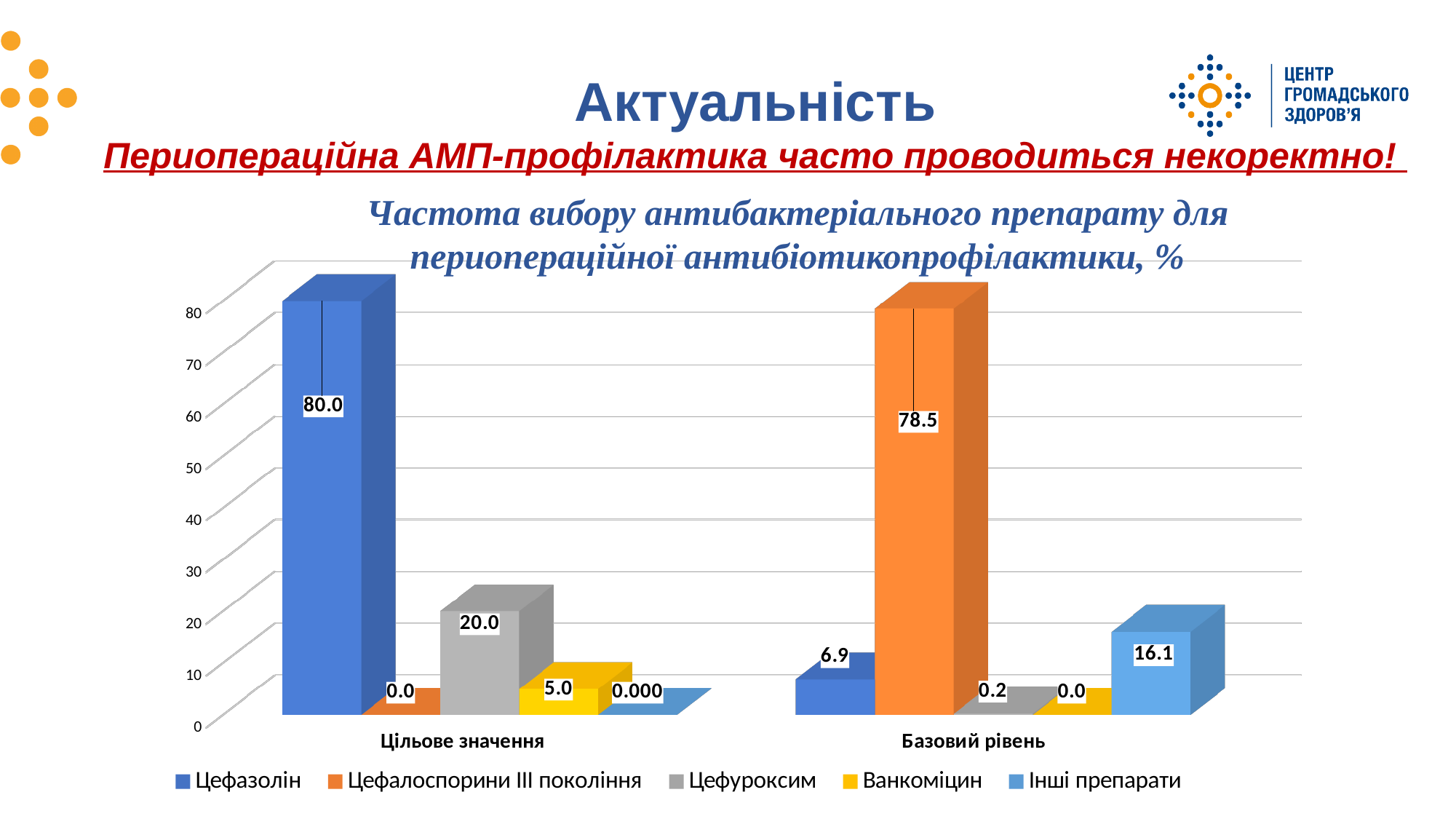
Which series has the highest value in the Цільове значення category? Цефазолін What is the value for Цефалоспорини III покоління in the Базовий рівень category? 78.5 What kind of chart is shown on the slide? Bar chart How many series does the legend list? 5 How many categories are shown on the x axis? 2 Which series has the highest value in the Базовий рівень category? Цефалоспорини III покоління What is the value for Цефазолін in the Базовий рівень category? 6.9 Which is larger: the Цефуроксим value for Цільове значення or the Інші препарати value for Базовий рівень? Цефуроксим value for Цільове значення What is the value for Цефазолін in the Цільове значення category? 80.0 What is the value for Цефуроксим in the Цільове значення category? 20.0 What is the value for Інші препарати in the Базовий рівень category? 16.1 What is the difference between the Цефазолін value for Цільове значення and for Базовий рівень? 73.1